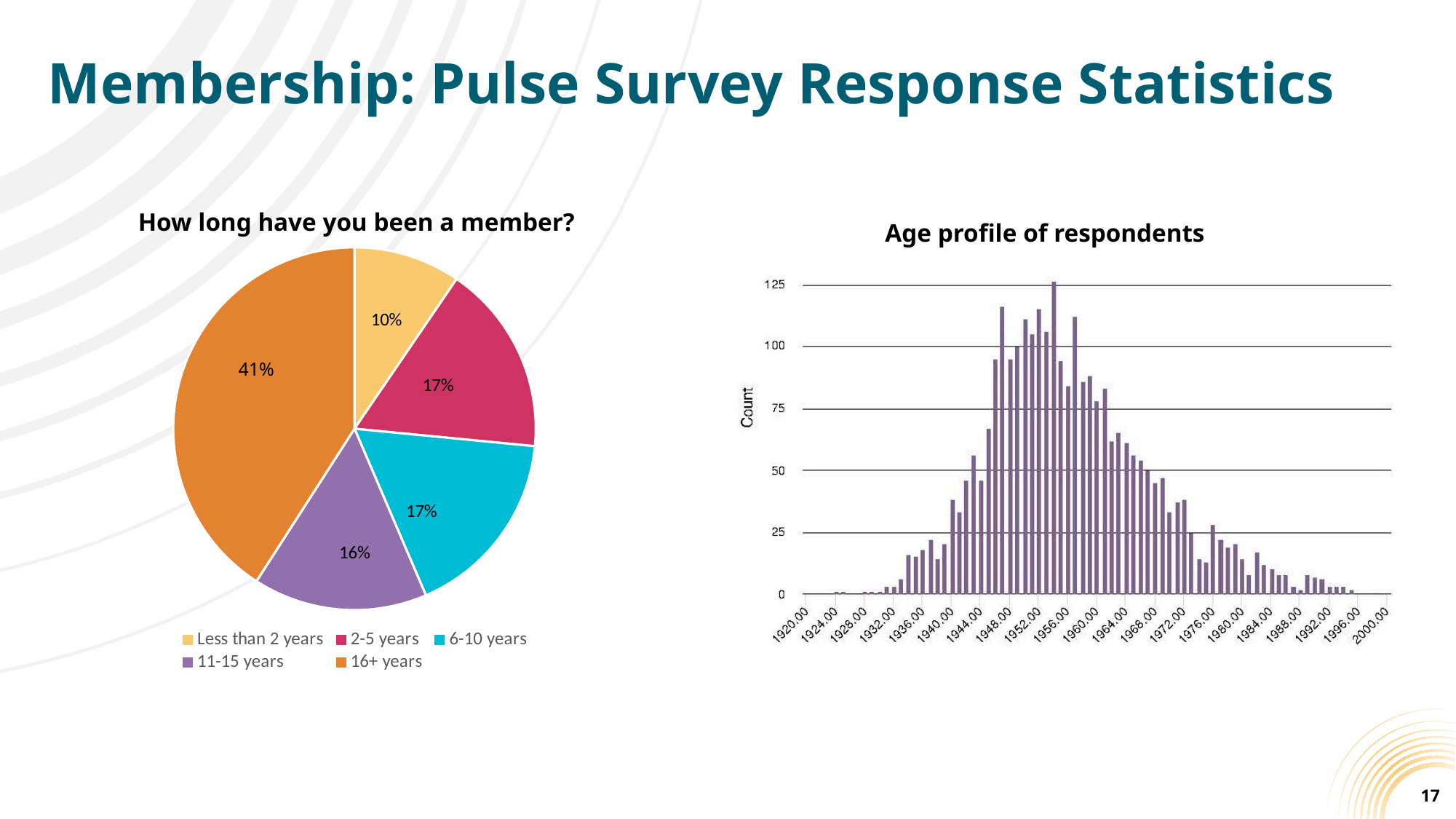
In the pie chart 'How long have you been a member?', which membership length category has the smallest share? Less than 2 years What kind of chart is 'How long have you been a member?'? Pie chart In the pie chart 'How long have you been a member?', which membership length category has the largest share? 16+ years In the pie chart 'How long have you been a member?', how many percentage points larger is the 16+ years share than the less than 2 years share? 31 percentage points In the pie chart 'How long have you been a member?', what percentage of respondents have been members for 11-15 years? 16% In the pie chart 'How long have you been a member?', how many categories does the legend list? 5 In the pie chart 'How long have you been a member?', what percentage of respondents have been members for less than 2 years? 10% In the pie chart 'How long have you been a member?', which is larger: the share for 16+ years or the share for 11-15 years? 16+ years In the pie chart 'How long have you been a member?', what percentage of respondents have been members for 16+ years? 41% What kind of chart is 'Age profile of respondents'? Bar chart In the 'Age profile of respondents' chart, is the tallest bar (around 1954) greater or less than 100? greater In the 'Age profile of respondents' chart, do the counts generally rise or fall from 1960 to 2000? fall